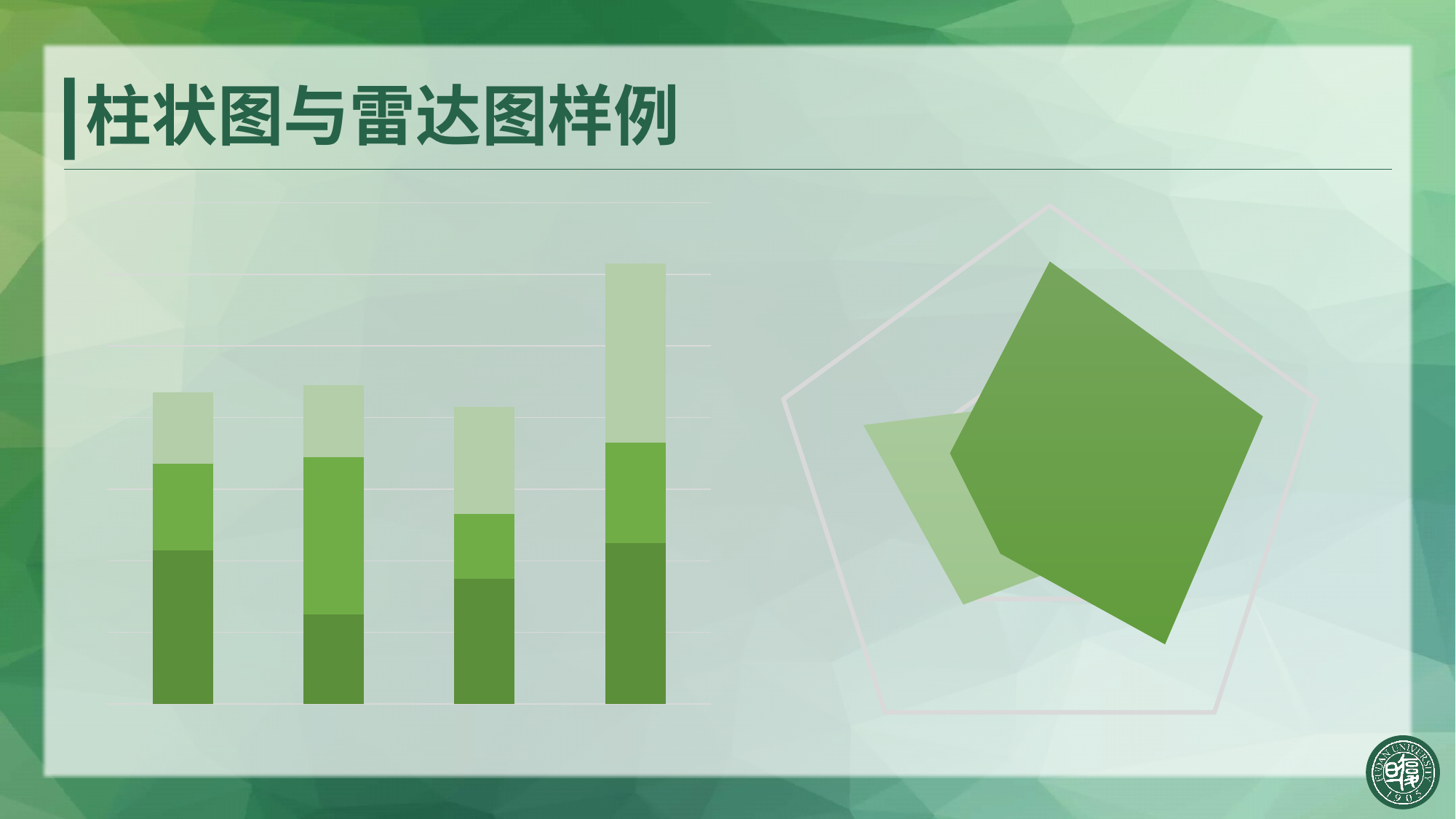
What is the title of the slide? 柱状图与雷达图样例 In the bar chart on the left, how many stacked segments does each bar have? 3 In the radar chart on the right, how many filled data series are shown? 2 In the bar chart on the left, which bar is the shortest overall? The third bar In the radar chart on the right, how many axes (points) does the pentagon grid have? 5 In the bar chart on the left, how many bars are plotted? 4 What kind of chart is the chart on the left side of the slide? Stacked bar chart In the bar chart on the left, is the fourth bar taller or shorter than the third bar? Taller What kind of chart is the chart on the right side of the slide? Radar chart In the bar chart on the left, which bar is the tallest overall? The fourth (rightmost) bar In the bar chart on the left, which bar has the largest light green (top) segment? The fourth (rightmost) bar In the bar chart on the left, which bar has the smallest dark green (bottom) segment? The second bar